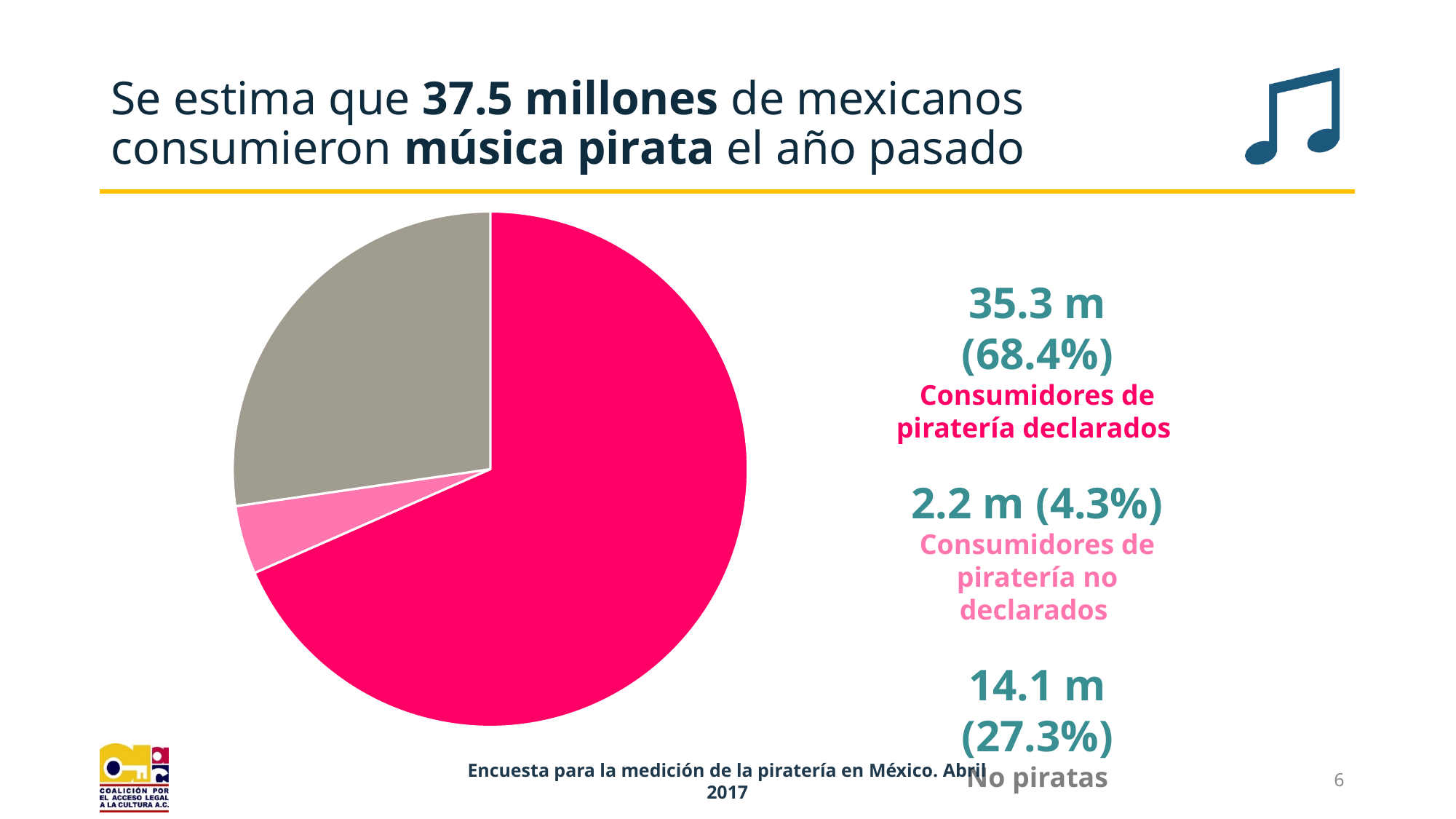
Which category has the largest slice of the pie? Consumidores de piratería declarados What share of the pie is 'Consumidores de piratería no declarados'? 4.3% How many slices does the pie chart have? 3 How many people are in the 'Consumidores de piratería no declarados' category? 2.2 m What share of the pie is 'No piratas'? 27.3% What share of the pie is 'Consumidores de piratería declarados'? 68.4% Which category has the smallest slice of the pie? Consumidores de piratería no declarados How many people are in the 'No piratas' category? 14.1 m What is the difference in millions between 'Consumidores de piratería declarados' and 'No piratas'? 21.2 m How many people are in the 'Consumidores de piratería declarados' category? 35.3 m What kind of chart is shown on the slide? pie chart Which is larger, 'No piratas' or 'Consumidores de piratería no declarados'? No piratas